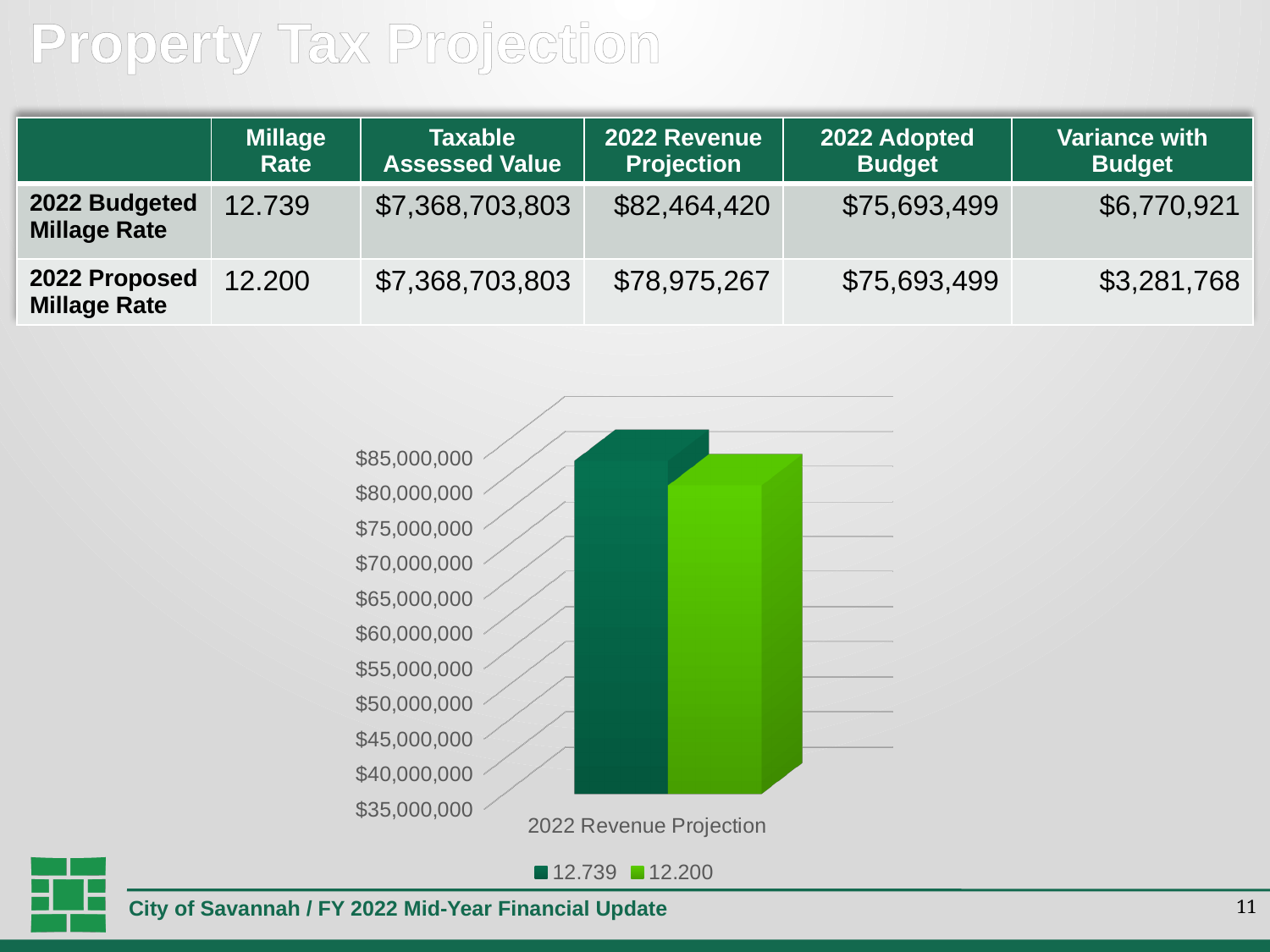
How many series does the chart legend list? 2 Is the value of the 12.200 bar greater or less than $85,000,000? less What is the difference between the 2022 Revenue Projection at the 12.739 millage rate and at the 12.200 millage rate? $3,489,153 How many categories are shown on the x axis of the chart? 1 What kind of chart is shown on the slide? bar chart Is the value of the 12.200 bar greater or less than $75,000,000? greater What is the category label on the x axis of the chart? 2022 Revenue Projection Which series has the taller bar in the chart, 12.739 or 12.200? 12.739 Is the value of the 12.739 bar greater or less than $80,000,000? greater What are the two series names shown in the chart legend? 12.739 and 12.200 What is the 2022 Revenue Projection for the 12.739 millage rate, as printed on the slide? $82,464,420 What is the 2022 Revenue Projection for the 12.200 millage rate, as printed on the slide? $78,975,267